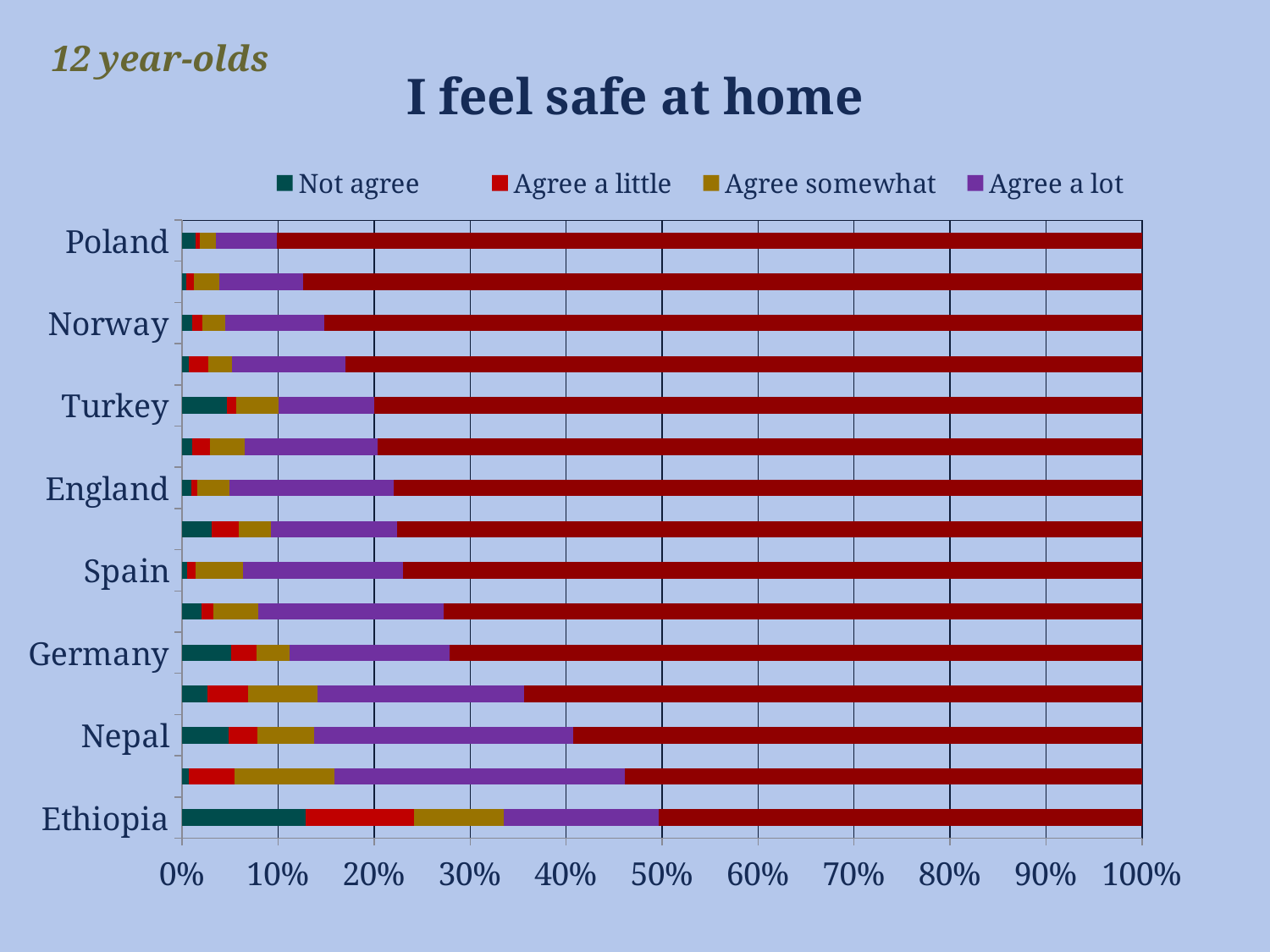
How many bars are plotted in the chart? 15 Is the 'Not agree' value for Ethiopia greater or less than 10%? greater Which has the larger 'Agree a lot' segment, Ethiopia or Poland? Ethiopia Which has the larger 'Not agree' segment, Ethiopia or Poland? Ethiopia Is the 'Agree a lot' value for Germany greater or less than 10%? greater Among the labelled countries, which has the smallest 'Agree a lot' segment? Poland What is the title of the chart? I feel safe at home How many series does the legend list? 4 What kind of chart is shown on the slide? Stacked horizontal bar chart Which has the larger 'Agree a little' segment, Ethiopia or Nepal? Ethiopia Among the labelled countries, which has the largest 'Not agree' segment? Ethiopia Which age group does the slide say the chart refers to? 12 year-olds